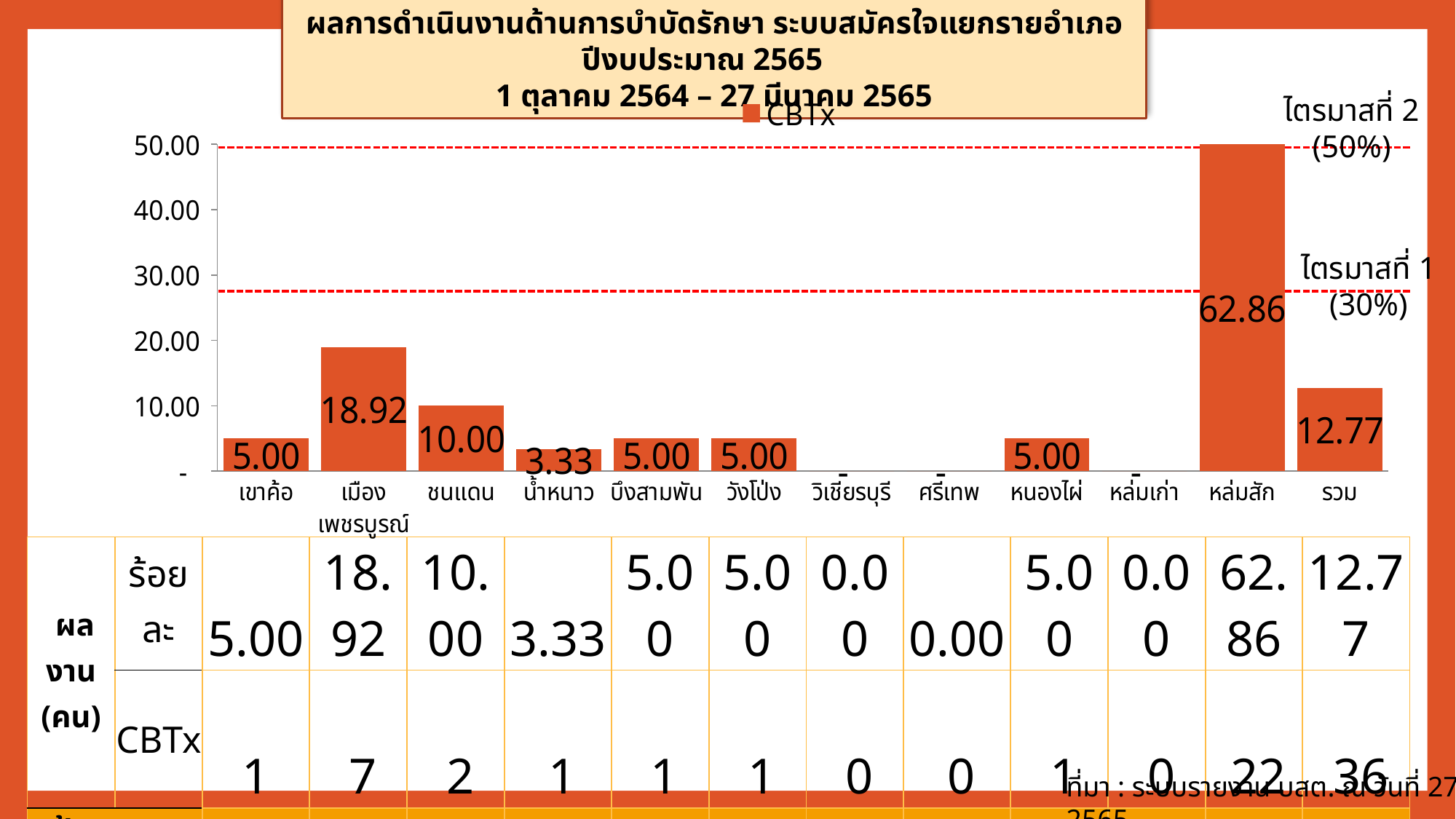
What is the difference between the values for หล่มสัก and เมืองเพชรบูรณ์? 43.94 What kind of chart is shown on the slide? bar chart Which category has the highest value in the chart? หล่มสัก What is the value for น้ำหนาว in the chart? 3.33 What is the value for รวม in the chart? 12.77 How many series does the chart legend list? 1 What is the value for หล่มสัก in the chart? 62.86 What is the difference between the values for ชนแดน and น้ำหนาว? 6.67 How many categories are shown on the x axis of the chart? 12 What is the value for เมืองเพชรบูรณ์ in the chart? 18.92 Is the value for เมืองเพชรบูรณ์ greater or less than 10.00? greater Which is larger, the value for ชนแดน or the value for รวม? รวม